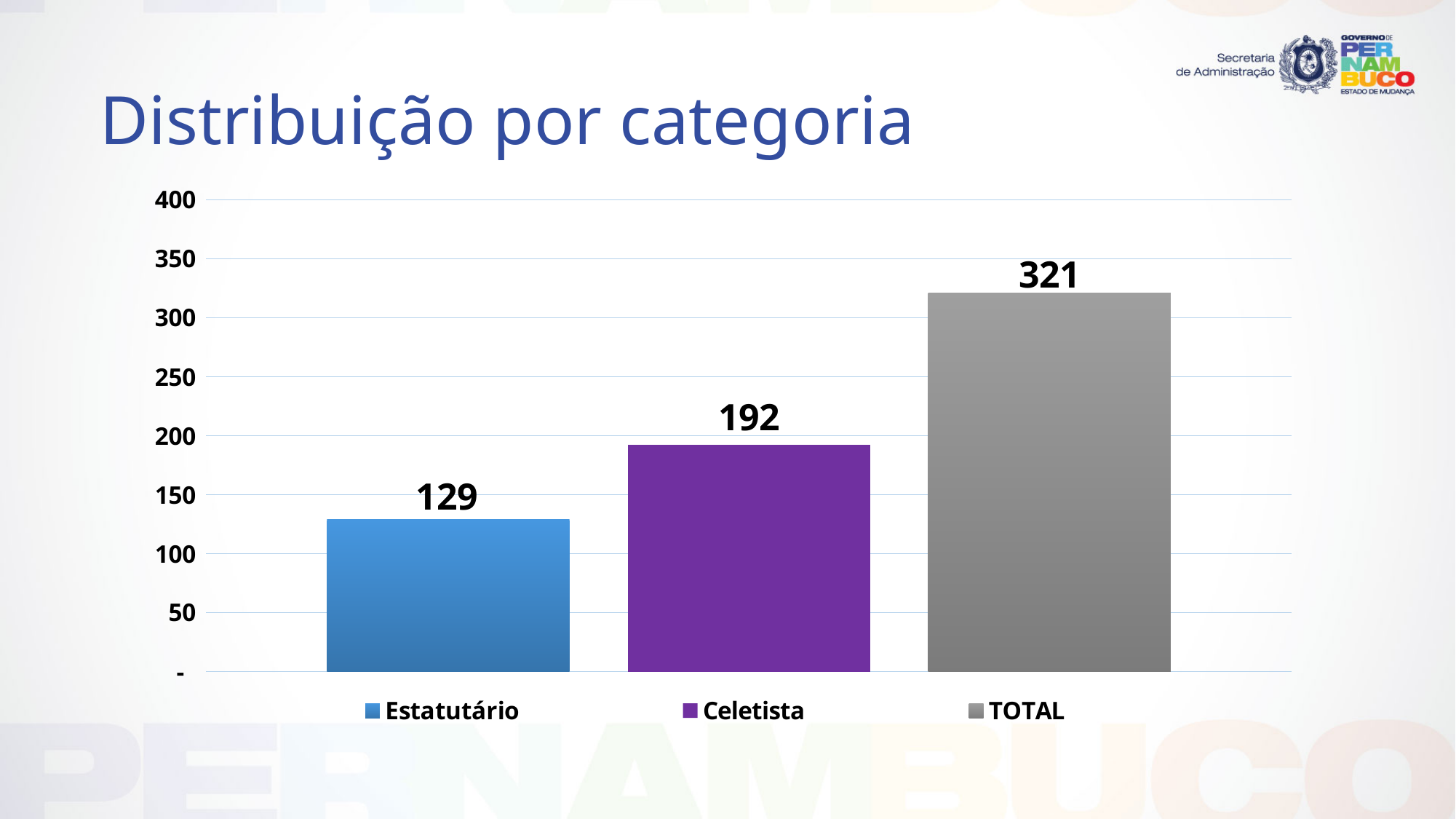
What is the value for TOTAL? 321 How many entries does the legend list? 3 Which is larger, the value for Estatutário or the value for Celetista? Celetista Which category has the highest value? TOTAL Is the value for Celetista greater or less than 200? less What is the title of the slide? Distribuição por categoria How many bars are shown in the chart? 3 What kind of chart is shown on the slide? bar chart What is the difference between the values for Celetista and Estatutário? 63 Which category has the lowest value? Estatutário What is the value for Estatutário? 129 What is the value for Celetista? 192